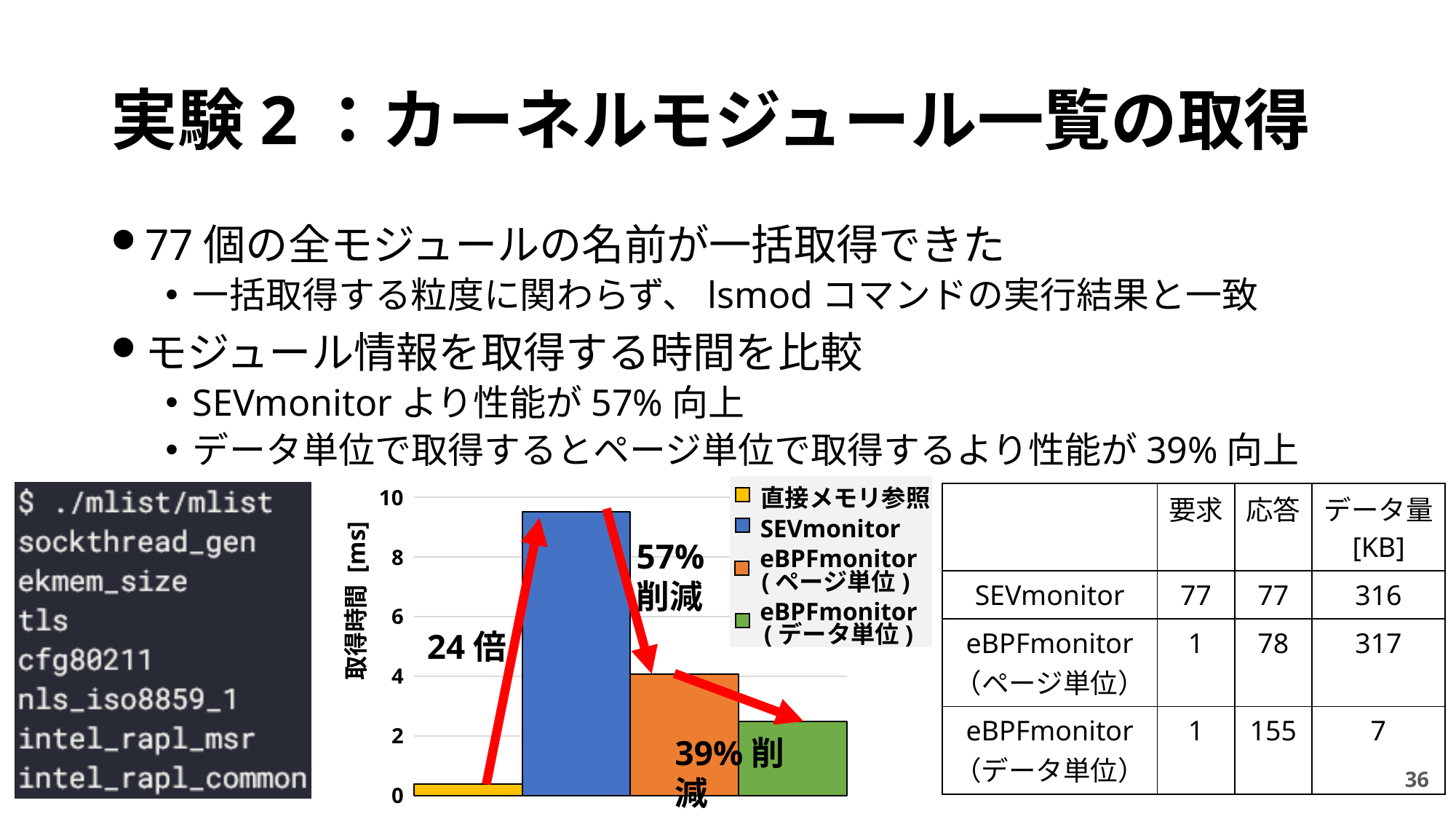
Is the 取得時間 for SEVmonitor greater or less than 8 ms? greater Which series has the lowest 取得時間 in the chart? 直接メモリ参照 How many entries does the chart legend list? 4 Is the 取得時間 for 直接メモリ参照 greater or less than 2 ms? less What kind of chart is shown on the slide? bar chart What is the label of the vertical axis of the chart? 取得時間 [ms] Is the 取得時間 for eBPFmonitor (データ単位) greater or less than 2 ms? greater Which has a larger 取得時間, eBPFmonitor (ページ単位) or eBPFmonitor (データ単位)? eBPFmonitor (ページ単位) Which series has the highest 取得時間 in the chart? SEVmonitor Which has a larger 取得時間, SEVmonitor or eBPFmonitor (ページ単位)? SEVmonitor What colour is the bar for SEVmonitor in the chart? blue